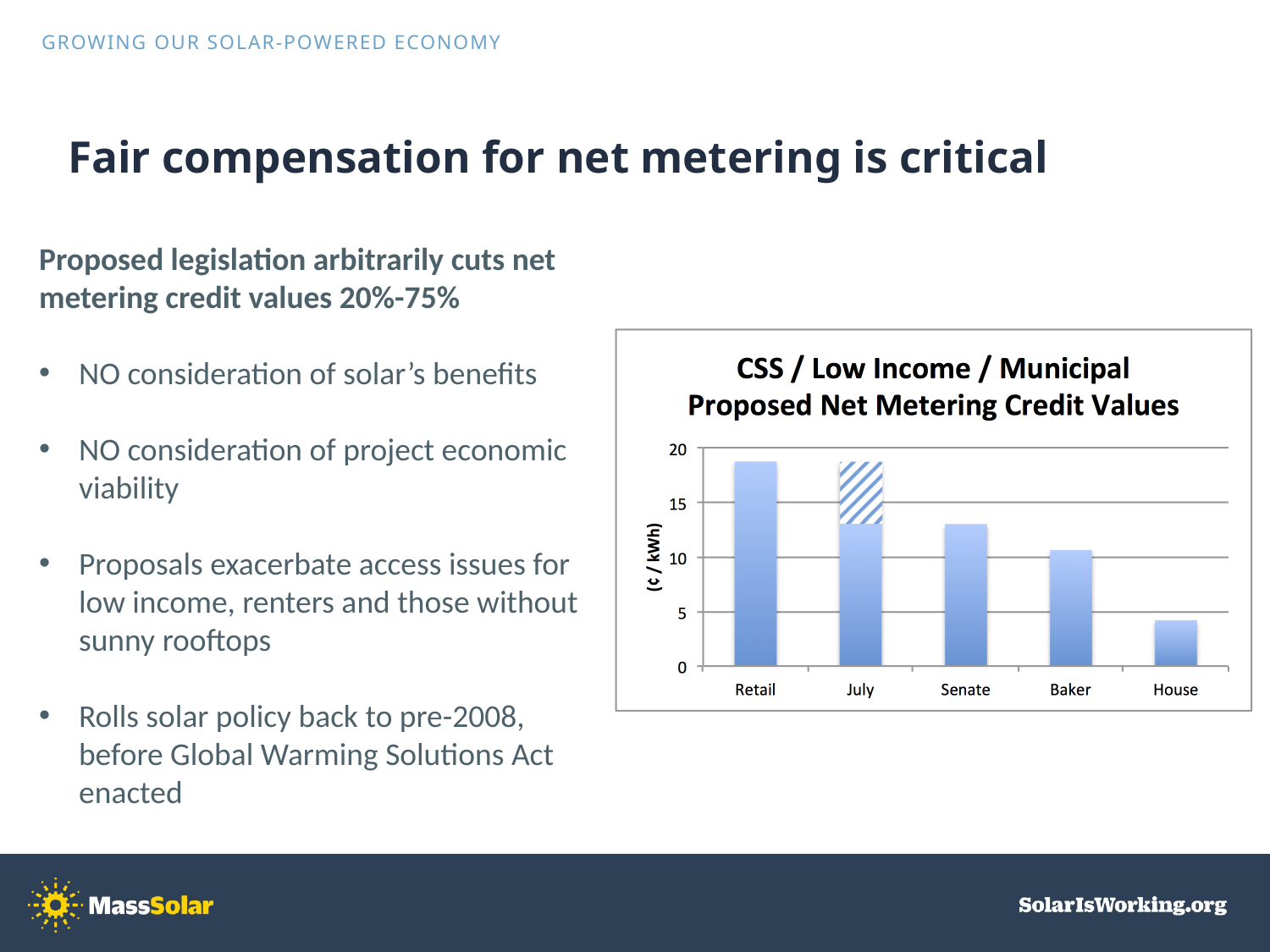
Which is larger, the value for Retail or the value for House? Retail How many categories are shown on the x axis of the chart? 5 What is the title of the chart? CSS / Low Income / Municipal Proposed Net Metering Credit Values Is the value for Senate greater or less than 15? less Is the value for Baker greater or less than 10? greater Which is larger, the value for Senate or the value for Baker? Senate What is the label on the y axis of the chart? (¢ / kWh) What kind of chart is shown on the slide? bar chart Which category has the lowest value in the chart? House Is the value for House greater or less than 5? less Do the bar values generally rise or fall from left to right across the x axis? fall